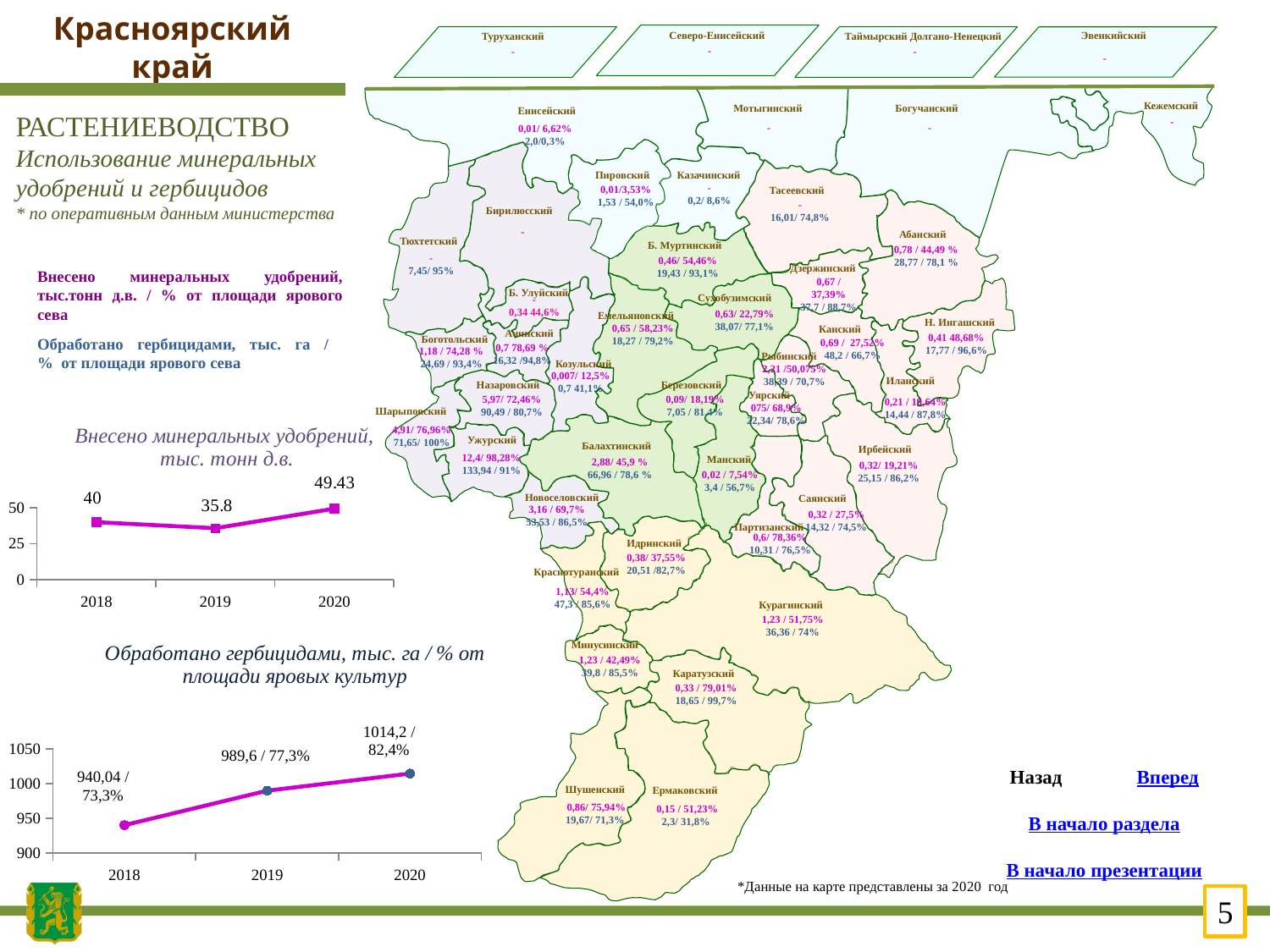
On the chart 'Внесено минеральных удобрений, тыс. тонн д.в.', which is larger, the value for 2018 or the value for 2019? 2018 What kind of chart is 'Обработано гербицидами, тыс. га / % от площади яровых культур'? line chart On the chart 'Внесено минеральных удобрений, тыс. тонн д.в.', what is the value for 2019? 35.8 On the chart 'Обработано гербицидами, тыс. га / % от площади яровых культур', is the value for 2019 greater or less than 1000? less On the chart 'Внесено минеральных удобрений, тыс. тонн д.в.', how many years are plotted? 3 On the chart 'Внесено минеральных удобрений, тыс. тонн д.в.', which year has the highest value? 2020 On the chart 'Обработано гербицидами, тыс. га / % от площади яровых культур', what is the data label for 2018? 940,04 / 73,3% On the chart 'Внесено минеральных удобрений, тыс. тонн д.в.', what is the value for 2020? 49.43 On the chart 'Обработано гербицидами, тыс. га / % от площади яровых культур', what is the data label for 2020? 1014,2 / 82,4% On the chart 'Внесено минеральных удобрений, тыс. тонн д.в.', what is the difference between the 2020 and 2019 values? 13.63 On the chart 'Внесено минеральных удобрений, тыс. тонн д.в.', which year has the lowest value? 2019 On the chart 'Обработано гербицидами, тыс. га / % от площади яровых культур', do the values rise or fall from 2018 to 2020? rise